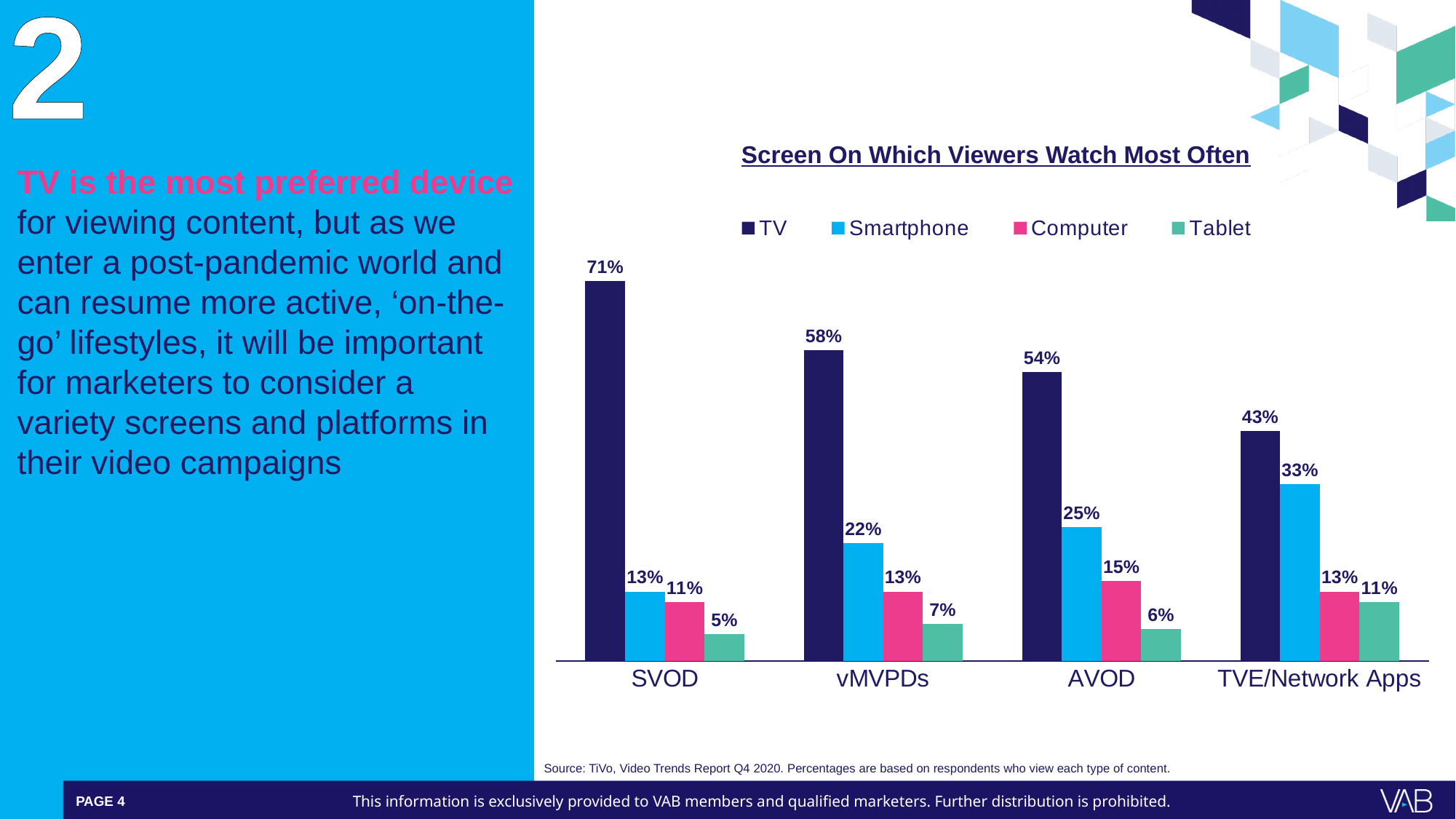
Which content type has the lowest Tablet value? SVOD How many content categories are shown on the x axis? 4 How many series does the legend list? 4 What is the Smartphone value for TVE/Network Apps? 33% What is the title of the chart? Screen On Which Viewers Watch Most Often What is the difference between the TV value and the Smartphone value for AVOD? 29% What percentage of viewers watch SVOD most often on TV? 71% What is the Computer value for vMVPDs? 13% Which content type has the highest TV value? SVOD Is the Smartphone value higher for vMVPDs or for TVE/Network Apps? TVE/Network Apps What kind of chart is shown on the slide? Bar chart What is the Tablet value for AVOD? 6%